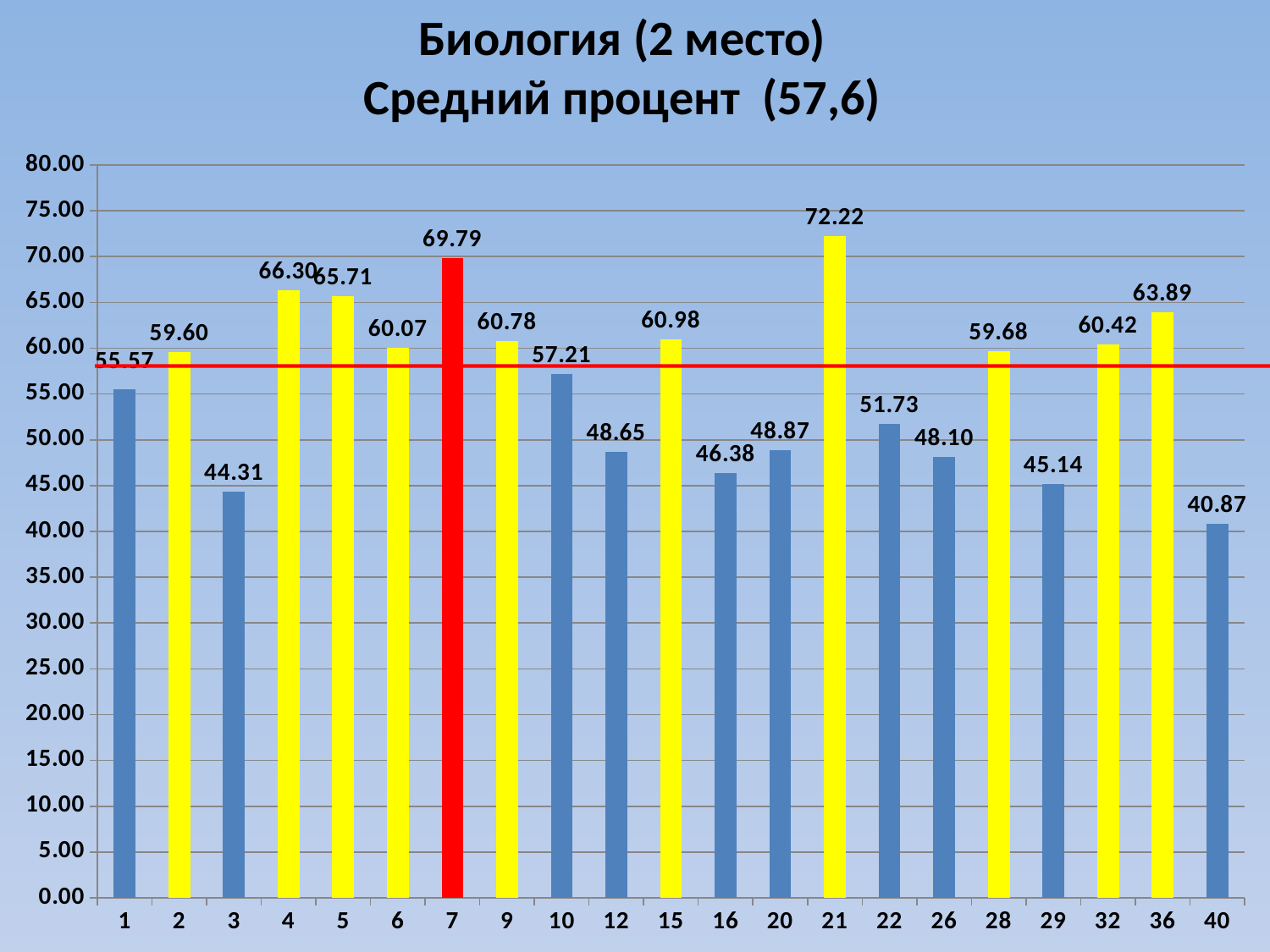
Which category has the lowest value? 40 What is the value for category 7? 69.79 What is the value for category 21? 72.22 What is the value for category 16? 46.38 What is the difference between the values for category 4 and category 3? 21.99 What kind of chart is shown on the slide? bar chart What is the value for category 40? 40.87 How many bars are plotted on the chart? 21 What is the difference between the values for category 21 and category 7? 2.43 Which category has the highest value? 21 Which is larger, the value for category 36 or the value for category 22? 36 What colour is the bar for category 7? red